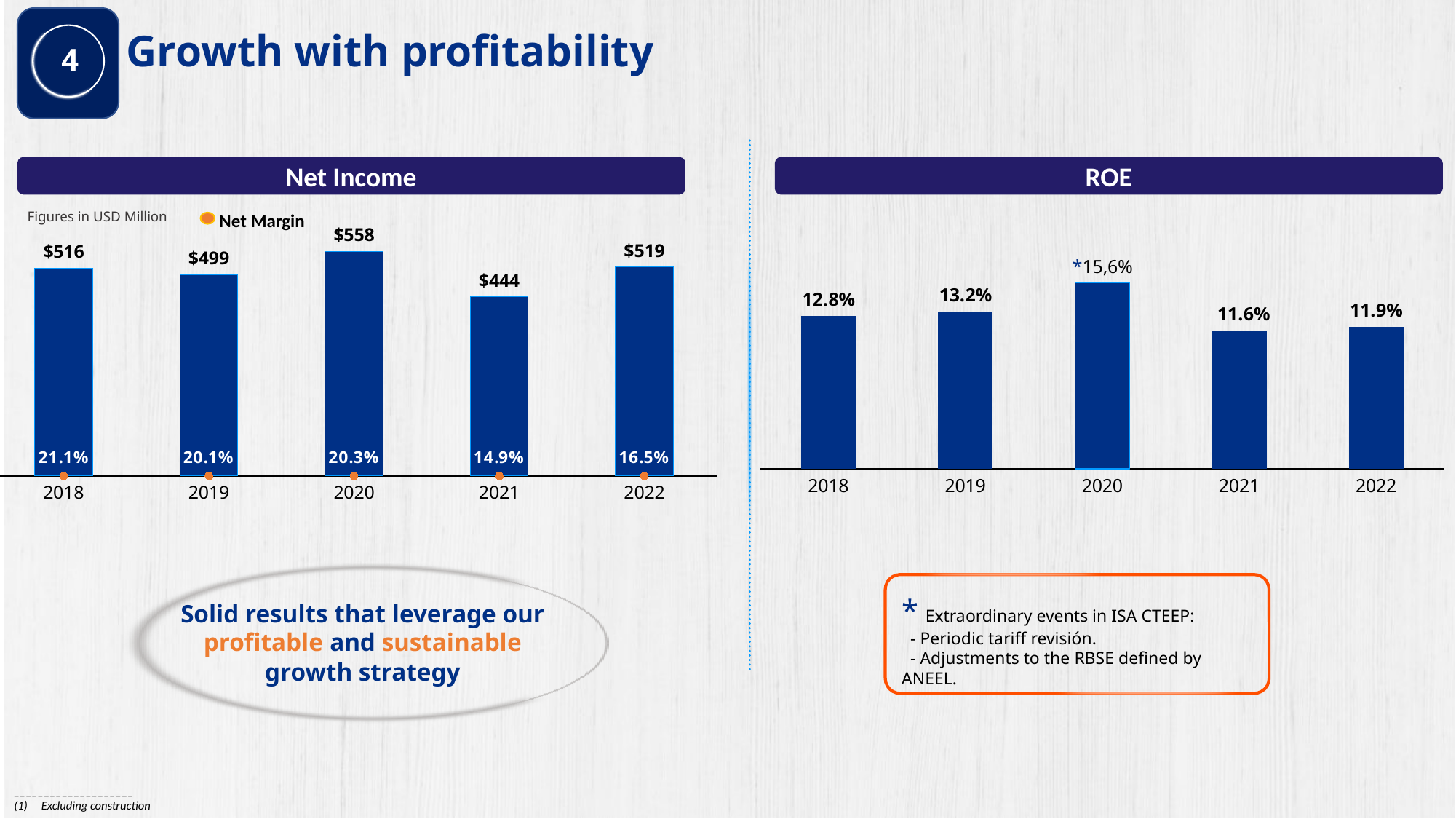
In the ROE chart, what is the ROE for 2019? 13.2% What kind of chart is the ROE chart? Bar chart In the Net Income chart, which year has the highest net income? 2020 In the ROE chart, which year has the lowest ROE? 2021 In the Net Income chart, what is the difference between net income in 2020 and 2021? $114 In the Net Income chart, which year has the lowest net income? 2021 In the Net Income chart, how many years are shown on the x axis? 5 In the Net Income chart, what is the net margin for 2021? 14.9% In the ROE chart, what is the difference between ROE in 2019 and 2018? 0.4% In the ROE chart, which year has the highest ROE? 2020 In the Net Income chart, is net income higher in 2018 or 2022? 2022 In the Net Income chart, what is the net income for 2020? $558